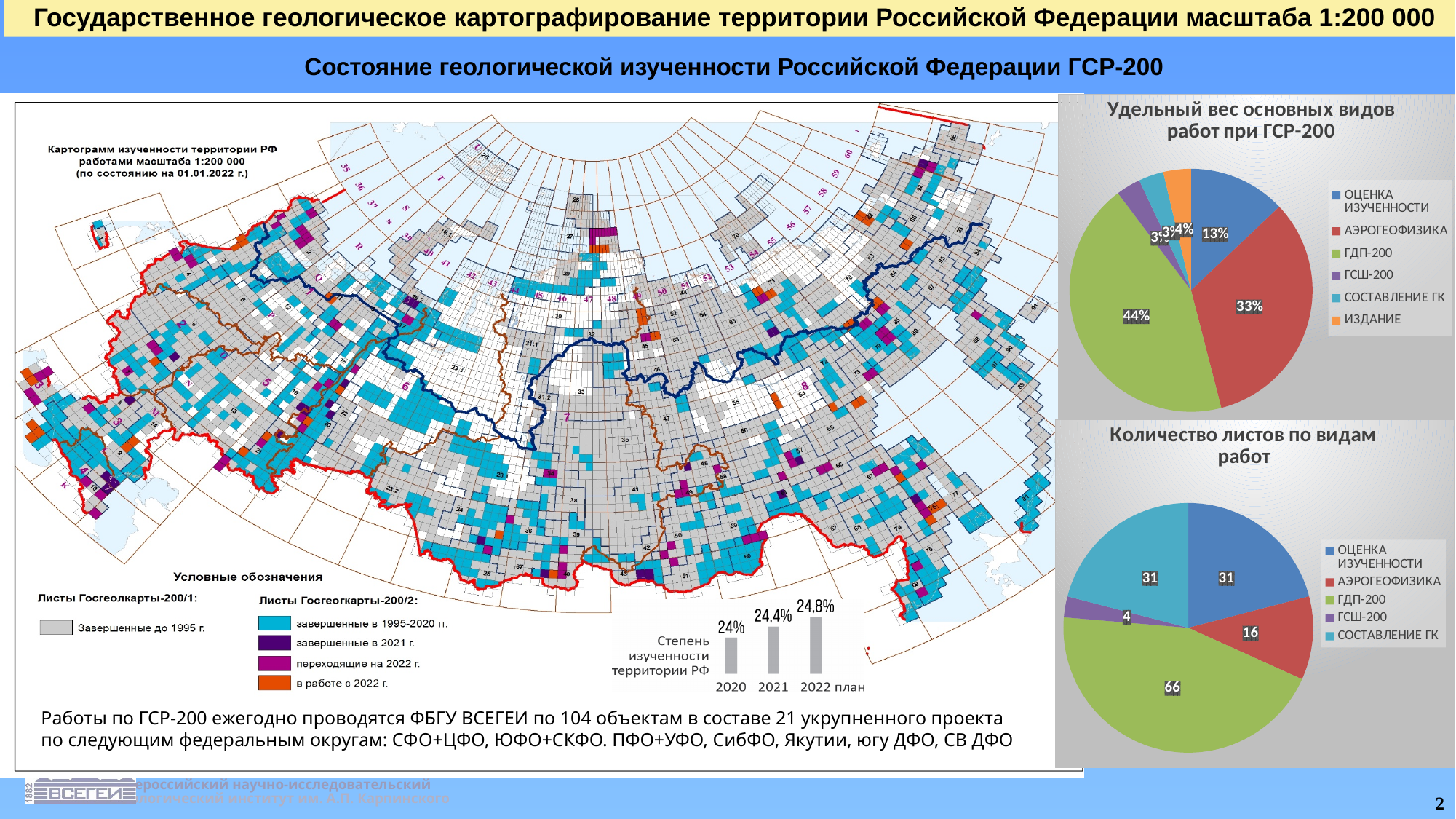
In the chart 'Удельный вес основных видов работ при ГСР-200', how many entries does the legend list? 6 In the small bar chart 'Степень изученности территории РФ' on the map, what is the value for 2021? 24,4% In the chart 'Количество листов по видам работ', how many categories does the legend list? 5 In the chart 'Удельный вес основных видов работ при ГСР-200', what is the difference between the shares of ГДП-200 and ОЦЕНКА ИЗУЧЕННОСТИ? 31% What kind of chart is 'Количество листов по видам работ'? Pie chart In the chart 'Удельный вес основных видов работ при ГСР-200', what share does АЭРОГЕОФИЗИКА have? 33% In the chart 'Количество листов по видам работ', what is the value for ГДП-200? 66 In the chart 'Удельный вес основных видов работ при ГСР-200', what share does ГДП-200 have? 44% In the chart 'Количество листов по видам работ', which is larger: ОЦЕНКА ИЗУЧЕННОСТИ or АЭРОГЕОФИЗИКА? ОЦЕНКА ИЗУЧЕННОСТИ In the chart 'Удельный вес основных видов работ при ГСР-200', which category has the largest share? ГДП-200 In the chart 'Количество листов по видам работ', which category has the smallest value? ГСШ-200 In the chart 'Количество листов по видам работ', what is the value for АЭРОГЕОФИЗИКА? 16